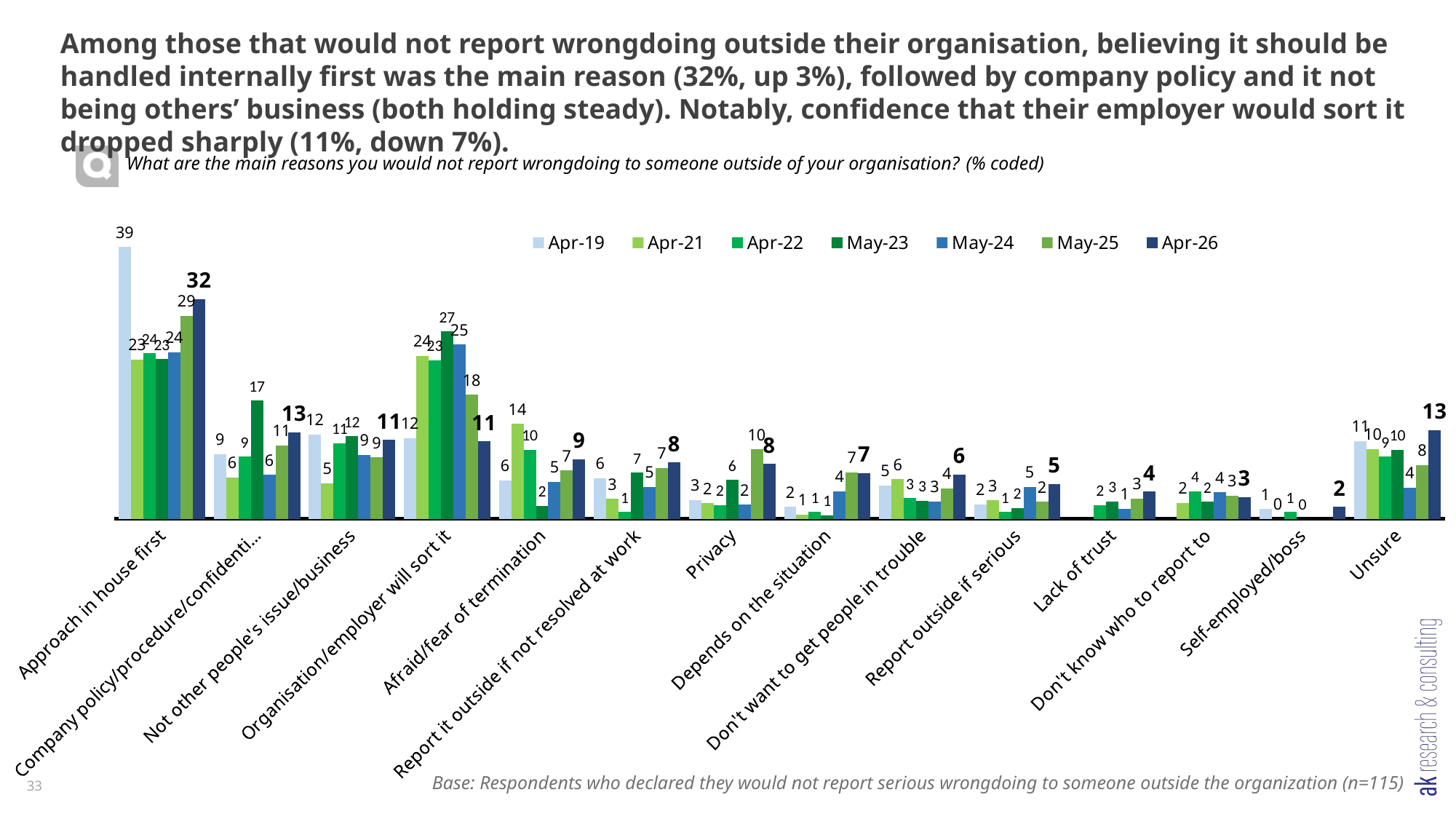
How many series does the legend list? 7 What is the Apr-26 value for 'Unsure'? 13 What is the Apr-26 value for 'Approach in house first'? 32 Which category has the lowest Apr-26 value? Self-employed/boss What is the difference between the Apr-26 and May-25 values for 'Approach in house first'? 3 What kind of chart is shown on the slide? Bar chart What is the Apr-19 value for 'Approach in house first'? 39 What is the May-23 value for 'Organisation/employer will sort it'? 27 Which category has the highest Apr-26 value? Approach in house first What is the difference between the May-23 and Apr-26 values for 'Organisation/employer will sort it'? 16 Which is larger for 'Company policy/procedure/confidenti...': the May-23 value or the Apr-26 value? May-23 How many categories are shown on the x axis? 14